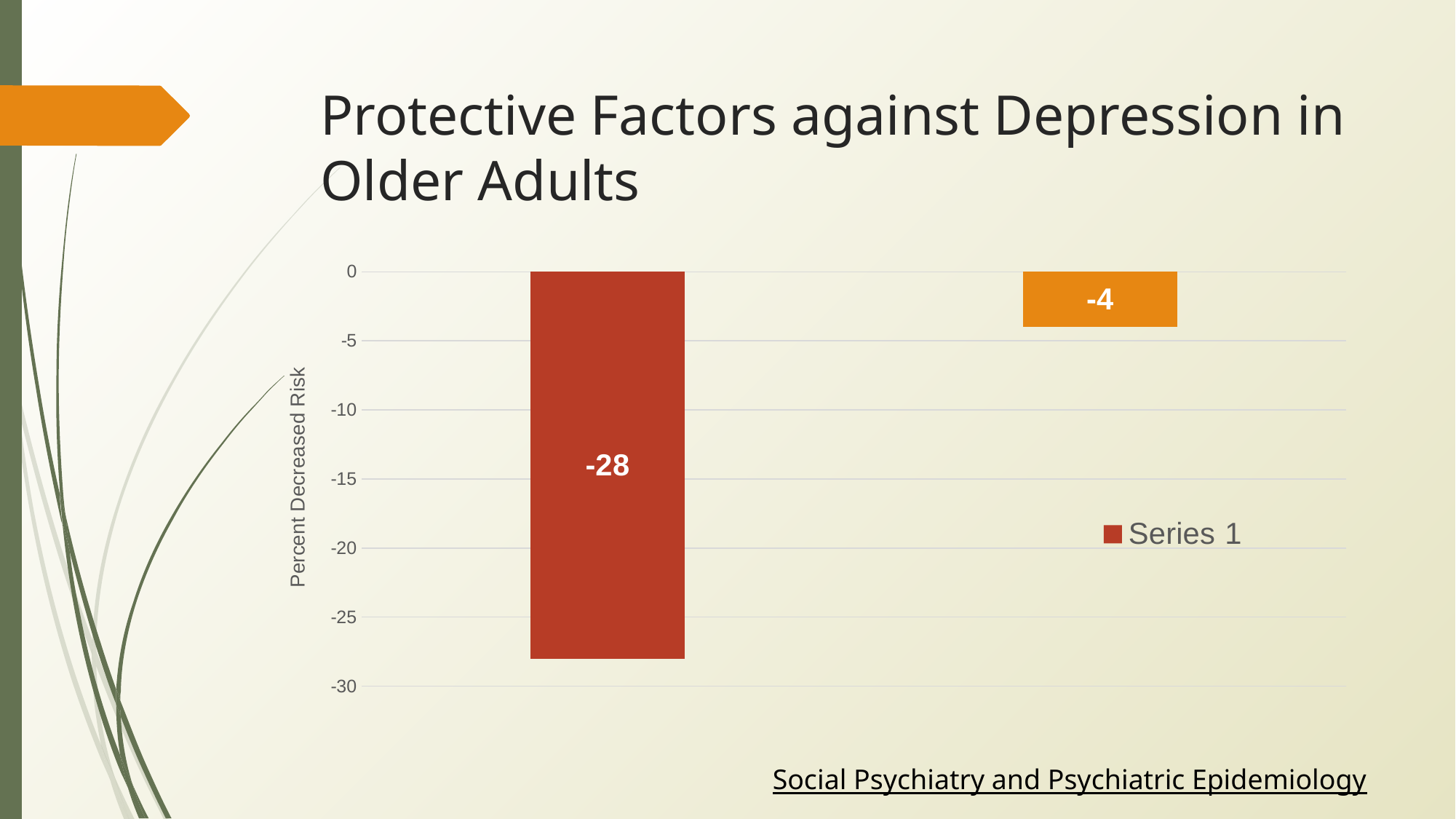
Which bar reaches the lowest value, the red bar on the left or the orange bar on the right? the red bar on the left What is the label on the vertical axis of the chart? Percent Decreased Risk What kind of chart is shown on the slide? bar chart How many bars are plotted in the chart? 2 What series name appears in the chart legend? Series 1 Is the value of the red bar on the left less than -25? Yes What is the difference between the values of the two bars (-28 and -4)? 24 How many series does the chart legend list? 1 What value is labelled on the red bar on the left of the chart? -28 Which bar has the value closer to zero, the red bar on the left or the orange bar on the right? the orange bar on the right What value is labelled on the orange bar on the right of the chart? -4